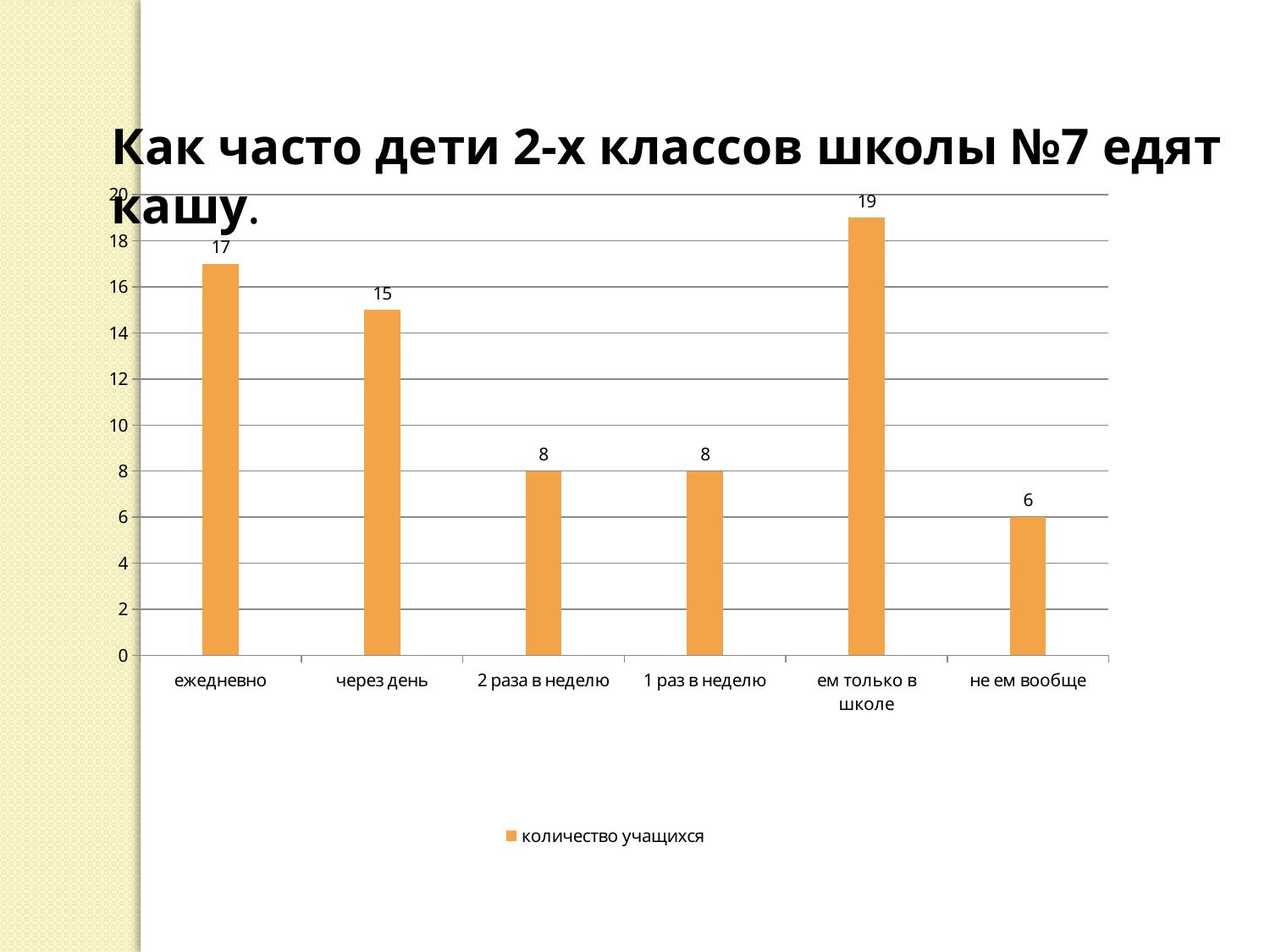
Which category has the lowest value? не ем вообще Which is larger, the value for "через день" or the value for "1 раз в неделю"? через день What is the value for "ем только в школе"? 19 What kind of chart is shown on the slide? bar chart What is the difference between the values for "ем только в школе" and "не ем вообще"? 13 What series name does the legend show? количество учащихся What is the value for "ежедневно"? 17 How many categories are shown on the x axis? 6 What is the value for "не ем вообще"? 6 Which category has the highest value? ем только в школе What is the difference between the values for "ежедневно" and "через день"? 2 Is the value for "2 раза в неделю" greater or less than 10? less